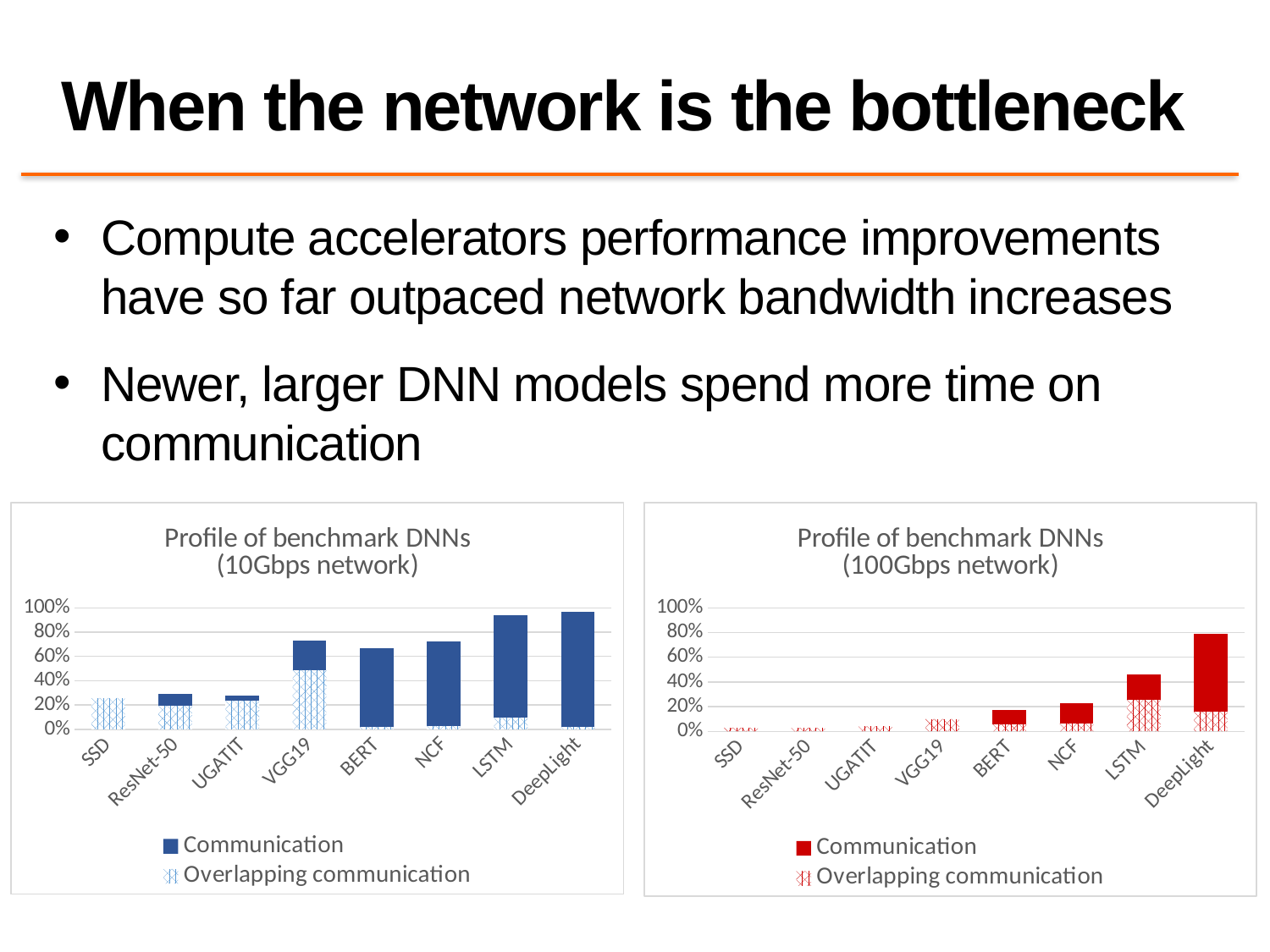
In the left chart (10Gbps network), do the total bar heights generally rise or fall from SSD to DeepLight along the x axis? Rise What kind of chart is the 'Profile of benchmark DNNs (10Gbps network)' chart on the left? Bar chart In the left chart (10Gbps network), is the total bar for SSD greater or less than 40%? less How many series does the legend of the right chart (100Gbps network) list? 2 What are the two legend entries of the left chart (10Gbps network)? Communication; Overlapping communication In the right chart (100Gbps network), which DNN has the highest total bar? DeepLight In the left chart (10Gbps network), is the total bar for DeepLight greater or less than 80%? greater How many DNN models are shown on the x axis of the left chart (10Gbps network)? 8 In the right chart (100Gbps network), which has the larger total bar, LSTM or VGG19? LSTM In the right chart (100Gbps network), is the total bar for DeepLight greater or less than 60%? greater In the left chart (10Gbps network), which has the larger total bar, LSTM or NCF? LSTM